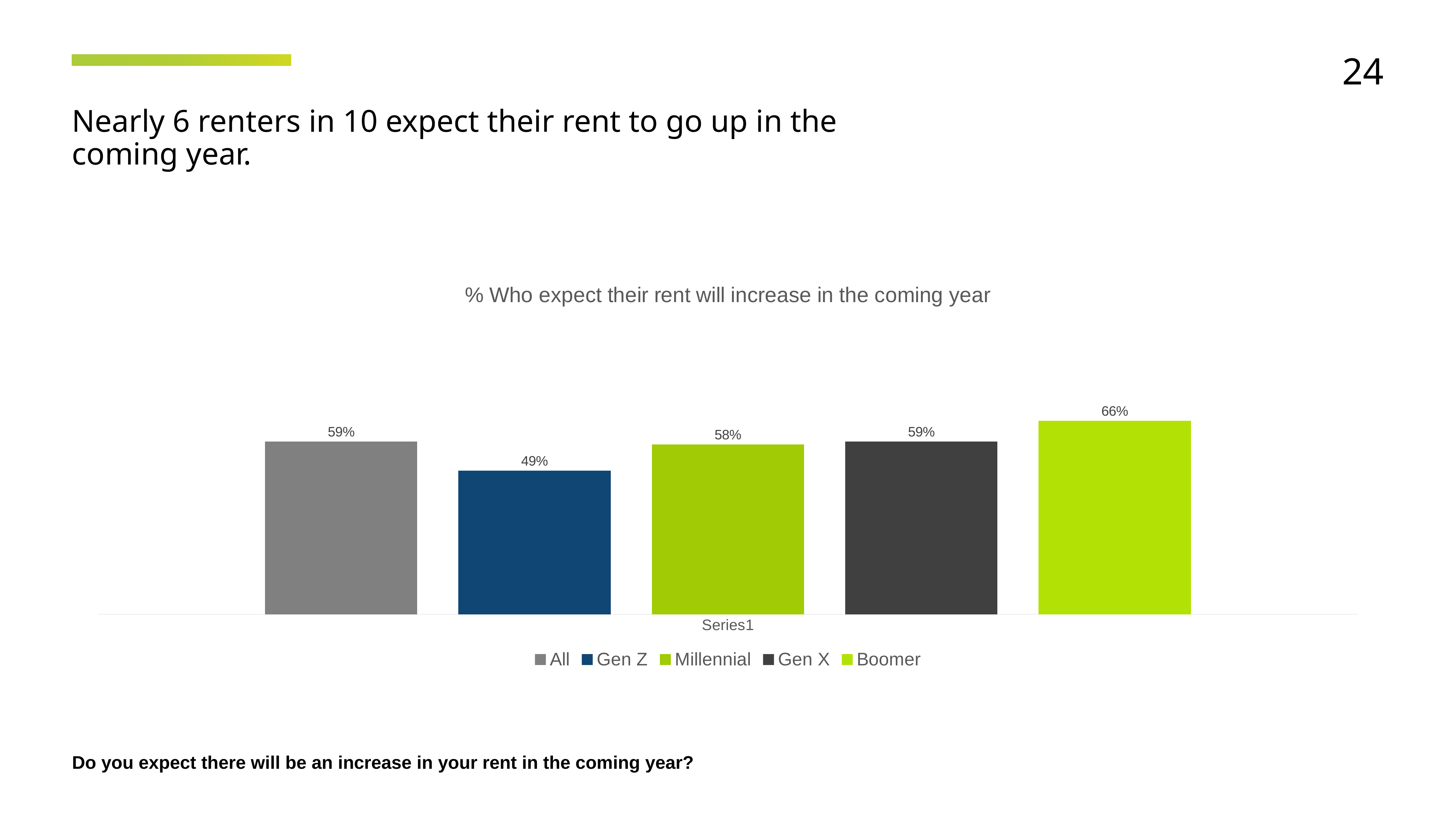
What is the title of the chart? % Who expect their rent will increase in the coming year What is the value shown for All renters? 59% What is the difference in percentage points between Boomer and Gen Z? 17 What percentage of Gen Z renters expect their rent will increase in the coming year? 49% How many series does the legend list? 5 What percentage of Boomer renters expect their rent will increase in the coming year? 66% What kind of chart is shown on the slide? Bar chart What is the difference in percentage points between Gen X and Millennial? 1 Which is larger, the value for Boomer or the value for Gen X? Boomer Which group has the highest percentage expecting a rent increase? Boomer Which group has the lowest percentage expecting a rent increase? Gen Z What is the value shown for Millennial renters? 58%